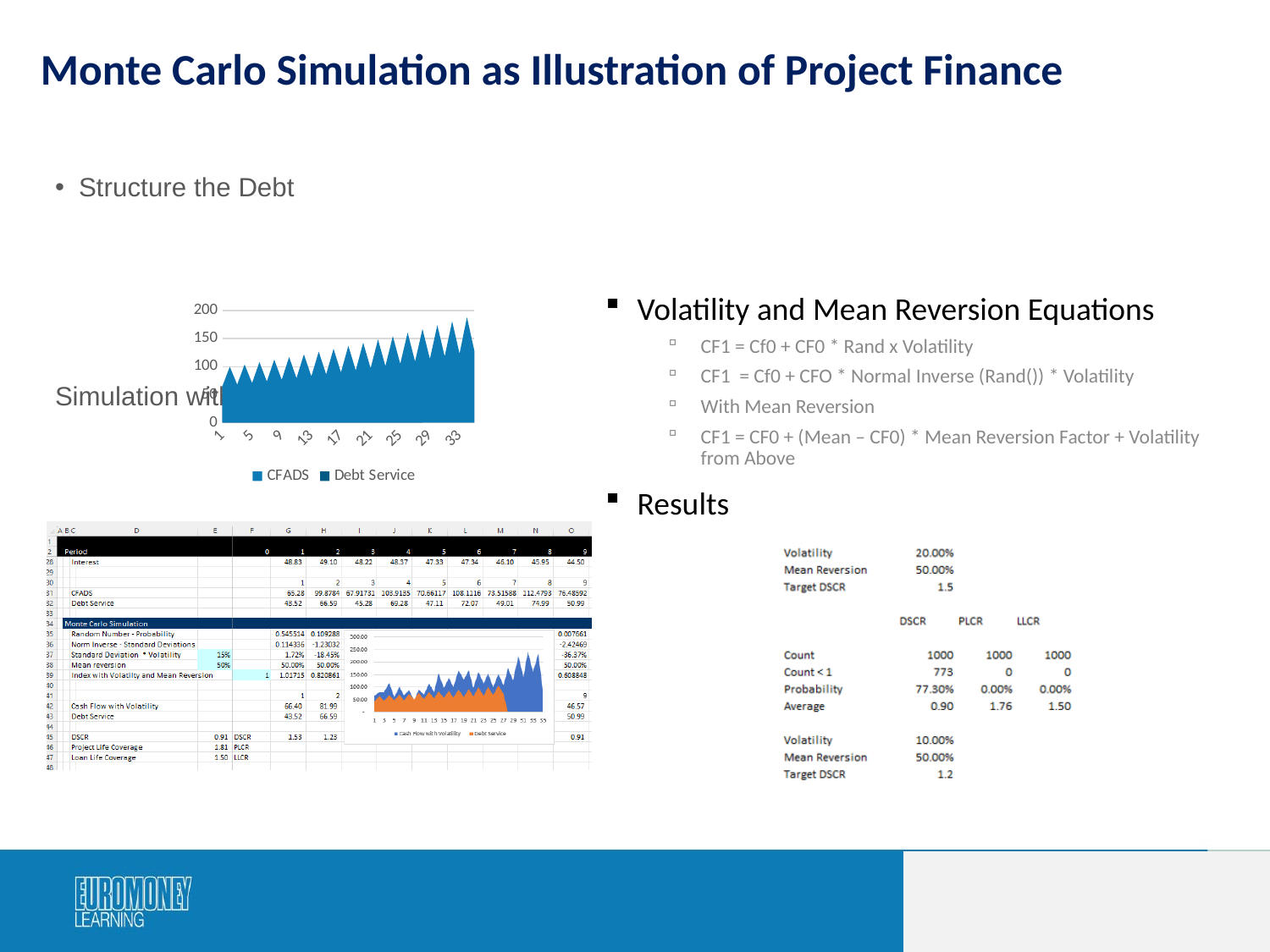
Is the highest CFADS value near the end of the chart greater or less than 150? greater What is the last tick label on the x axis of the chart? 33 Do the CFADS values generally rise or fall along the x axis of the chart? Rise How many tick labels are shown on the x axis of the chart? 9 What is the first tick label on the x axis of the chart? 1 Is the CFADS value at period 1 greater or less than 150? less How many series does the legend of the chart list? 2 What are the two series named in the chart legend? CFADS and Debt Service Is the CFADS value at period 1 greater or less than 50? greater What kind of chart is shown on the slide? Area chart What is the maximum value shown on the y axis of the chart? 200